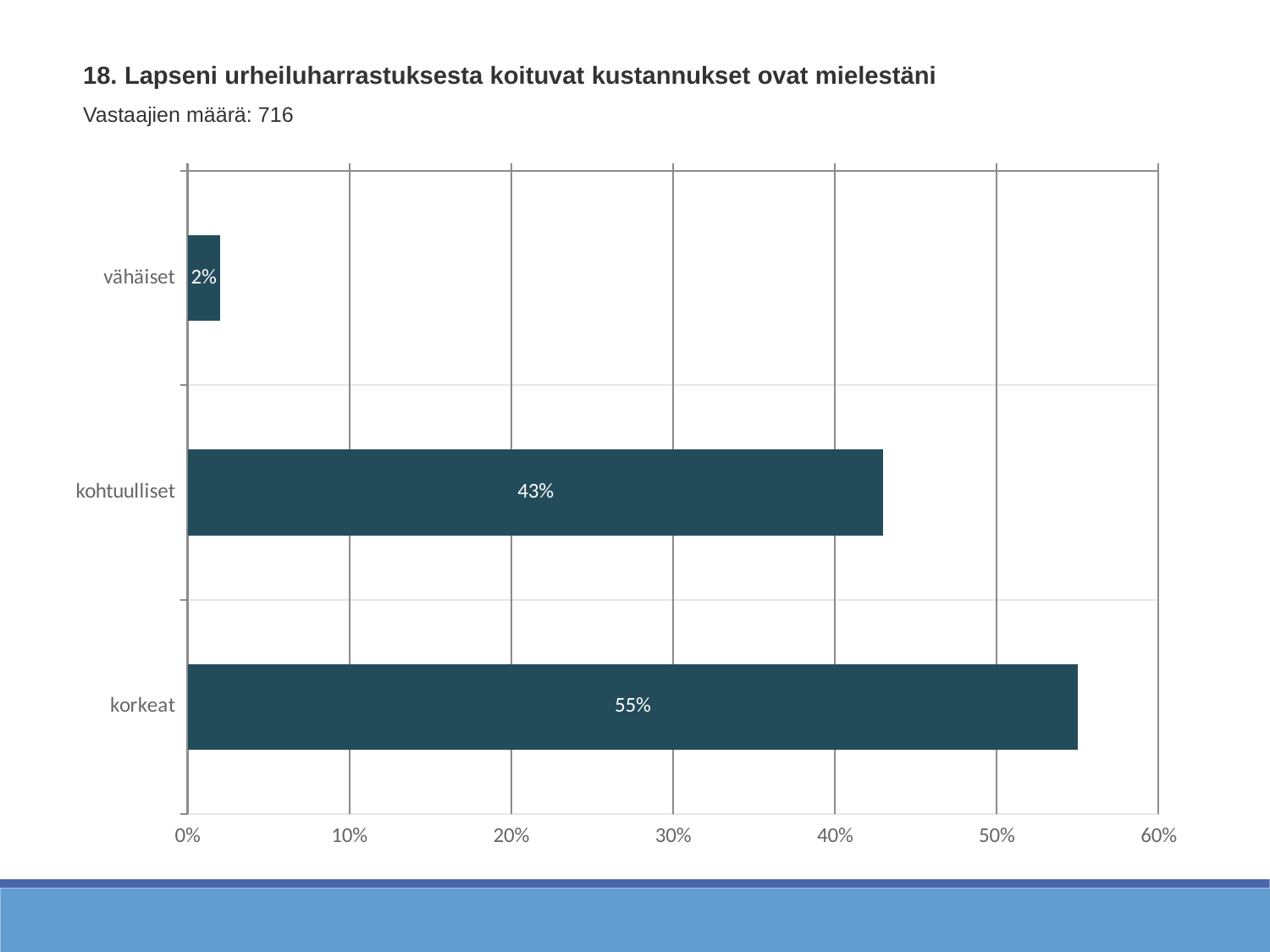
Is the value for "kohtuulliset" greater or less than 40%? greater Which is larger, the value for "kohtuulliset" or the value for "korkeat"? korkeat Which category has the lowest value? vähäiset What is the value for "korkeat"? 55% Which category has the highest value? korkeat What is the difference between the values for "korkeat" and "kohtuulliset"? 12% How many respondents (Vastaajien määrä) are reported on the slide? 716 What is the value for "vähäiset"? 2% How many categories are shown in the chart? 3 What is the difference between the values for "kohtuulliset" and "vähäiset"? 41% What kind of chart is shown on the slide? bar chart What is the value for "kohtuulliset"? 43%